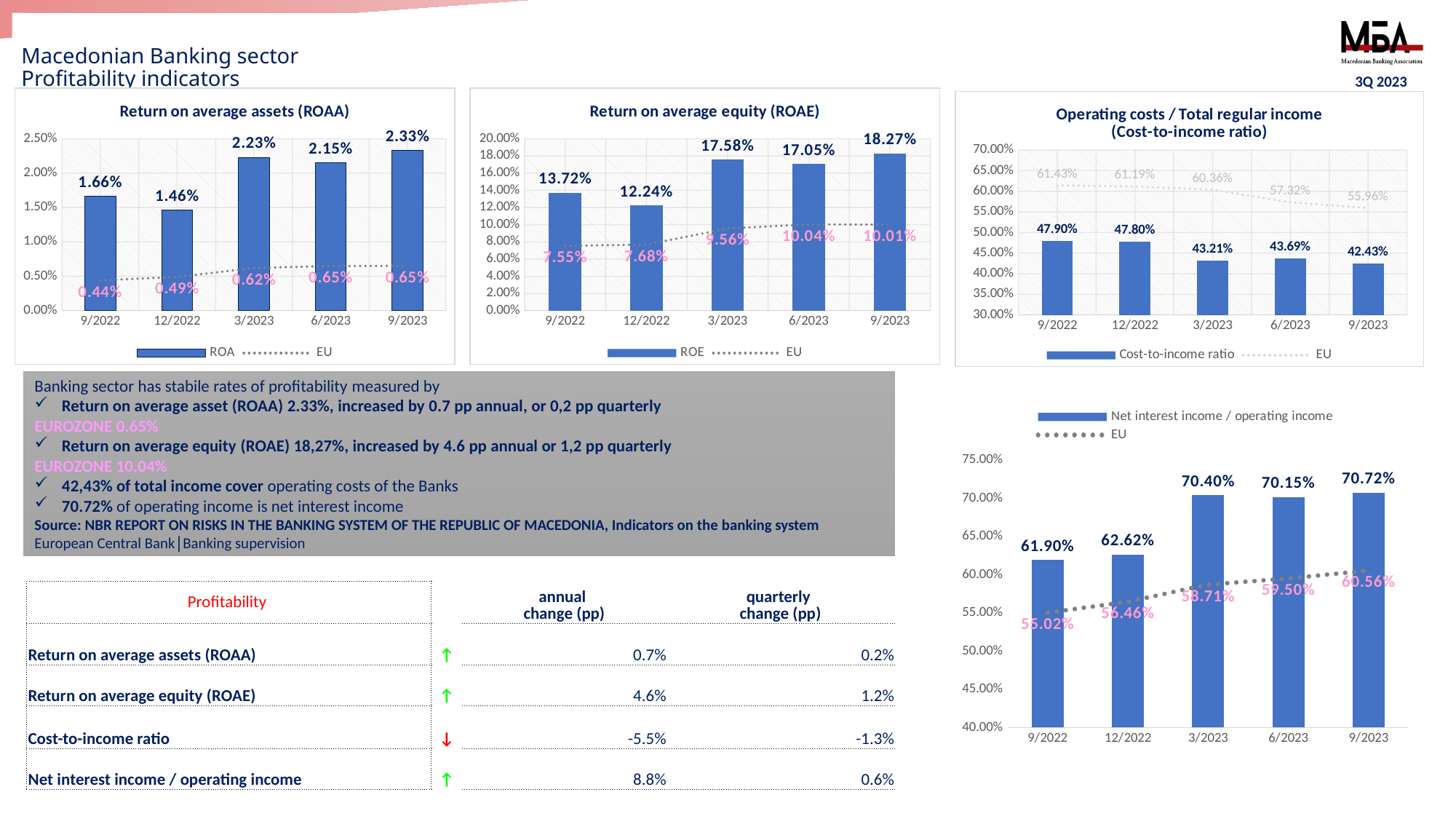
What type of chart is the 'Return on average assets (ROAA)' chart? bar chart with a line In the 'Operating costs / Total regular income (Cost-to-income ratio)' chart, does the EU value rise or fall from 9/2022 to 9/2023? fall In the 'Return on average assets (ROAA)' chart, what is the difference between the ROA value and the EU value for 9/2023? 1.68 pp In the 'Return on average assets (ROAA)' chart, what is the ROA value for 9/2023? 2.33% In the 'Return on average equity (ROAE)' chart, how many series does the legend list? 2 In the 'Return on average equity (ROAE)' chart, what is the EU value for 6/2023? 10.04% In the 'Return on average equity (ROAE)' chart, which period has the highest ROE value? 9/2023 In the 'Return on average assets (ROAA)' chart, which period has the lowest ROA value? 12/2022 In the 'Operating costs / Total regular income (Cost-to-income ratio)' chart, what is the Cost-to-income ratio for 3/2023? 43.21% In the 'Operating costs / Total regular income (Cost-to-income ratio)' chart, is the Cost-to-income ratio for 9/2022 larger or smaller than the EU value for 9/2022? smaller In the bottom-right chart, what is the Net interest income / operating income value for 12/2022? 62.62% In the bottom-right chart, how many periods are shown on the x axis? 5